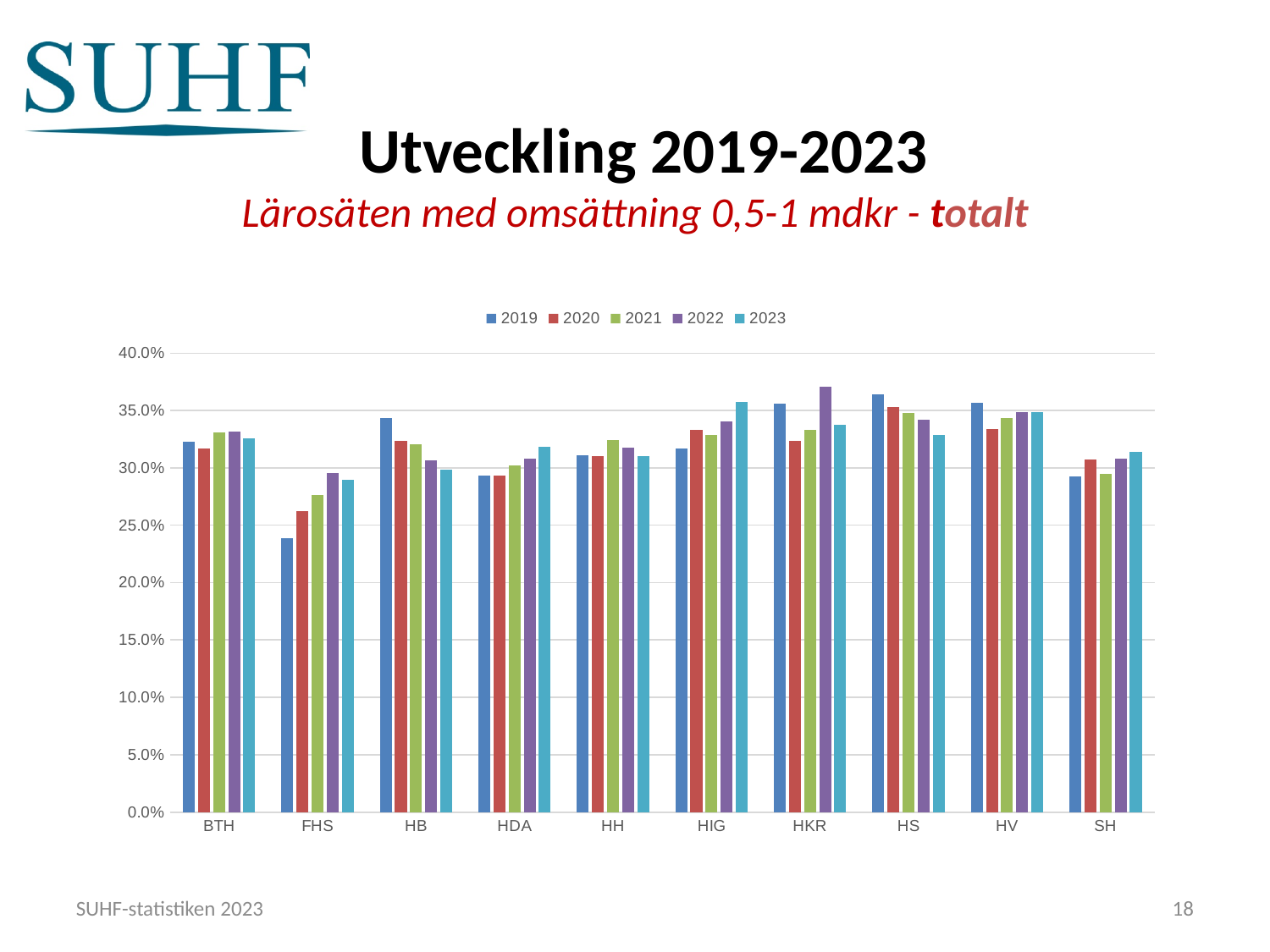
How many categories (institutions) are shown on the x axis? 10 What kind of chart is shown on the slide? bar chart Is the value for FHS in 2019 greater or less than 25%? less Is the value for HIG in 2023 greater or less than 35%? greater Is the value for HKR in 2022 greater or less than 35%? greater How many series does the legend list? 5 Which is larger for HS: the 2019 value or the 2023 value? 2019 Which is larger for HKR: the 2022 value or the 2023 value? 2022 Do the values for HS rise or fall from 2019 to 2023? fall What is the title of the slide? Utveckling 2019-2023 Which institution has the lowest bar for 2019? FHS